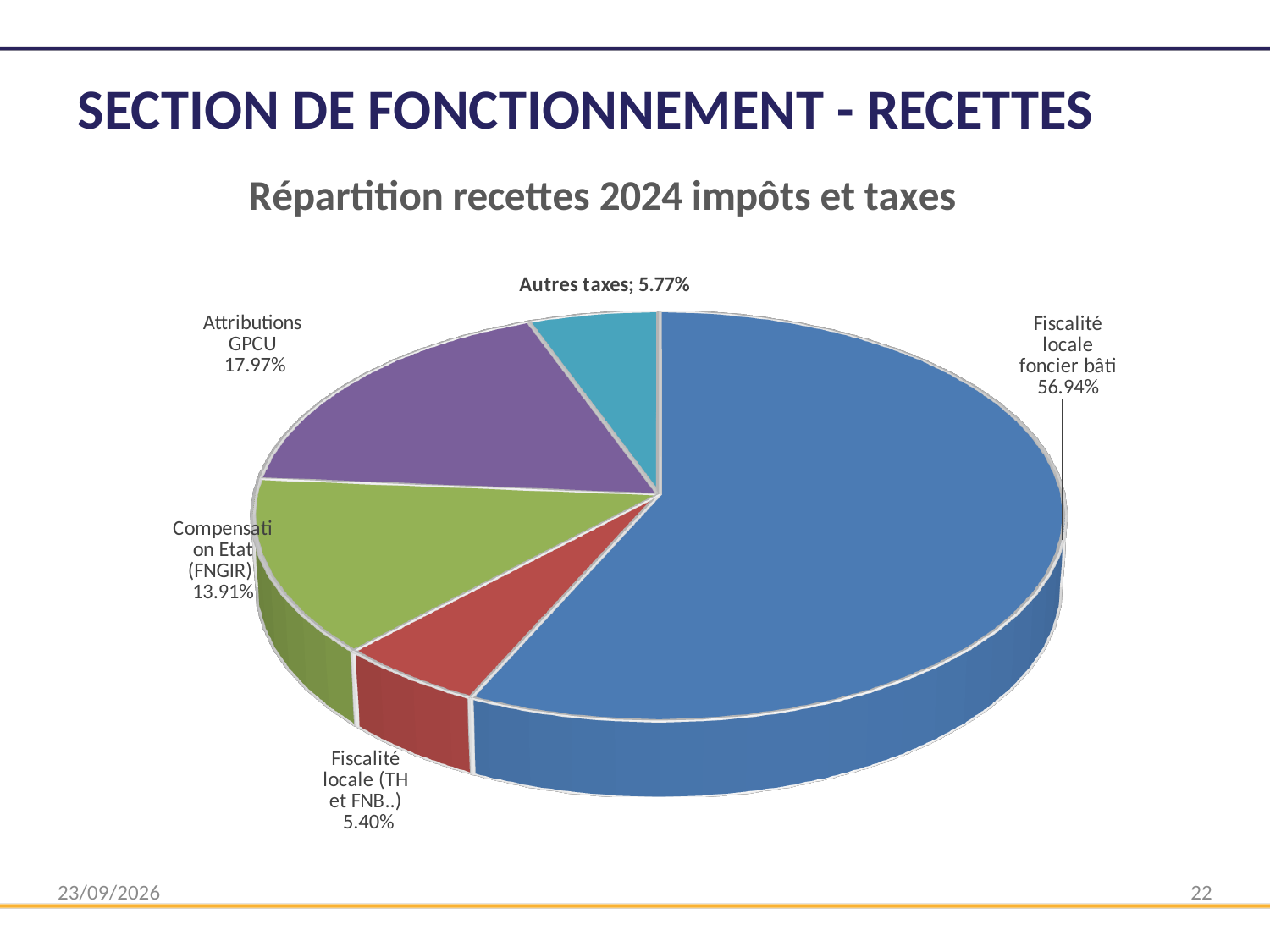
Which category has the smallest share of the pie? Fiscalité locale (TH et FNB..) What share of the pie is Fiscalité locale foncier bâti? 56.94% Which category has the largest share of the pie? Fiscalité locale foncier bâti What is the value shown for Attributions GPCU? 17.97% What is the value shown for Autres taxes? 5.77% What is the title of the chart? Répartition recettes 2024 impôts et taxes Which is larger, the share for Attributions GPCU or the share for Compensation Etat (FNGIR)? Attributions GPCU How many slices does the pie chart have? 5 What is the value shown for Fiscalité locale (TH et FNB..)? 5.40% What is the value shown for Compensation Etat (FNGIR)? 13.91% What type of chart is shown on the slide? Pie chart What is the difference in percentage points between Attributions GPCU and Compensation Etat (FNGIR)? 4.06